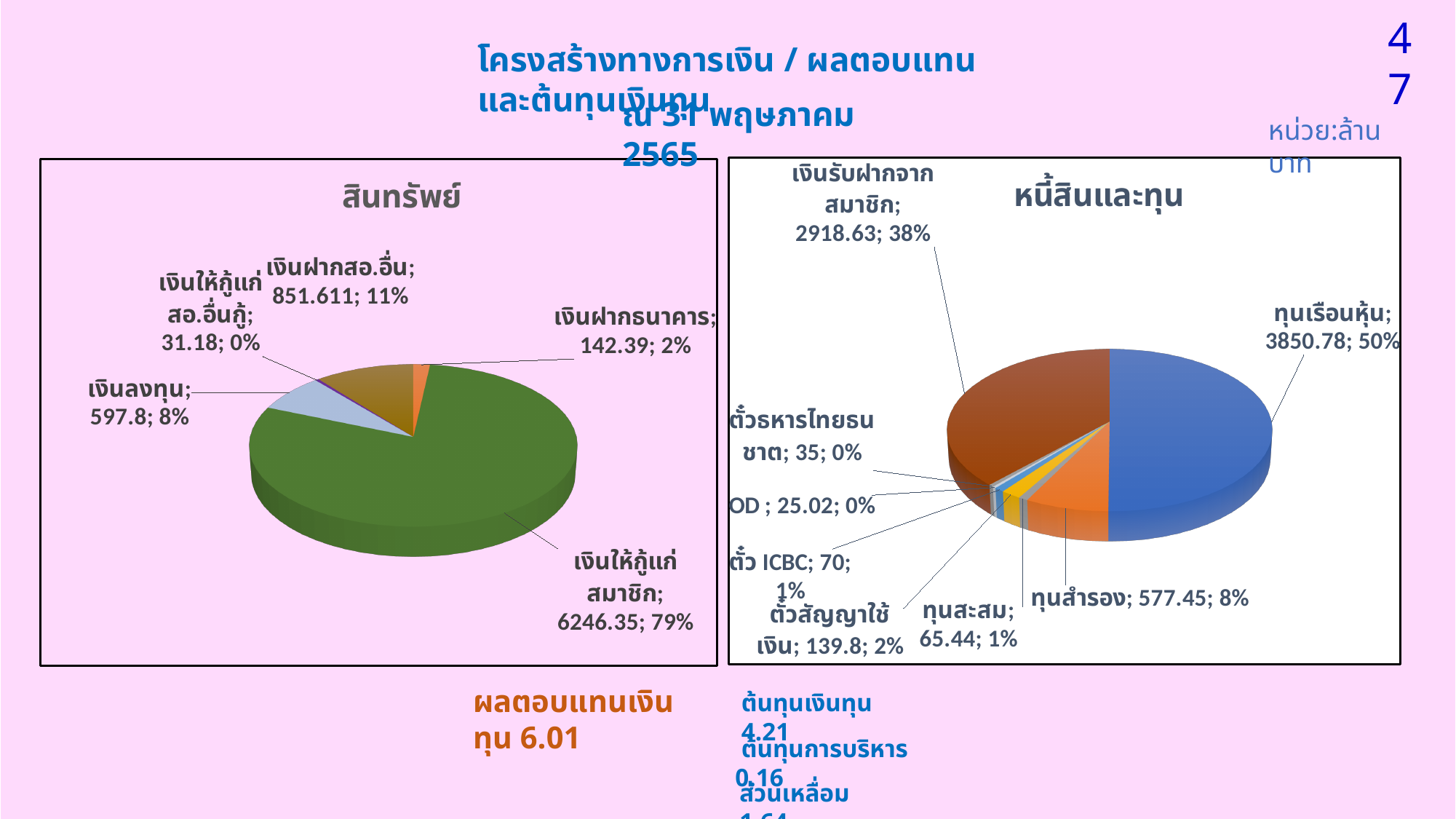
In the chart titled สินทรัพย์, how many categories are shown? 5 In the chart titled หนี้สินและทุน, which category has the largest value? ทุนเรือนหุ้น In the chart titled สินทรัพย์, what is the value for เงินให้กู้แก่สมาชิก? 6246.35 In the chart titled สินทรัพย์, which category has the smallest value? เงินให้กู้แก่สอ.อื่นกู้ In the chart titled หนี้สินและทุน, what is the value for ทุนเรือนหุ้น? 3850.78 In the chart titled หนี้สินและทุน, what share of the pie does เงินรับฝากจากสมาชิก represent? 38% What kind of chart is the chart titled สินทรัพย์? pie chart In the chart titled หนี้สินและทุน, what is the value for ตั๋ว ICBC? 70 In the chart titled หนี้สินและทุน, which is larger: ทุนสำรอง or ตั๋วสัญญาใช้เงิน? ทุนสำรอง In the chart titled สินทรัพย์, what share of the pie does เงินฝากสอ.อื่น represent? 11% In the chart titled หนี้สินและทุน, how many categories are shown? 8 In the chart titled สินทรัพย์, what is the difference between เงินลงทุน and เงินฝากธนาคาร? 455.41